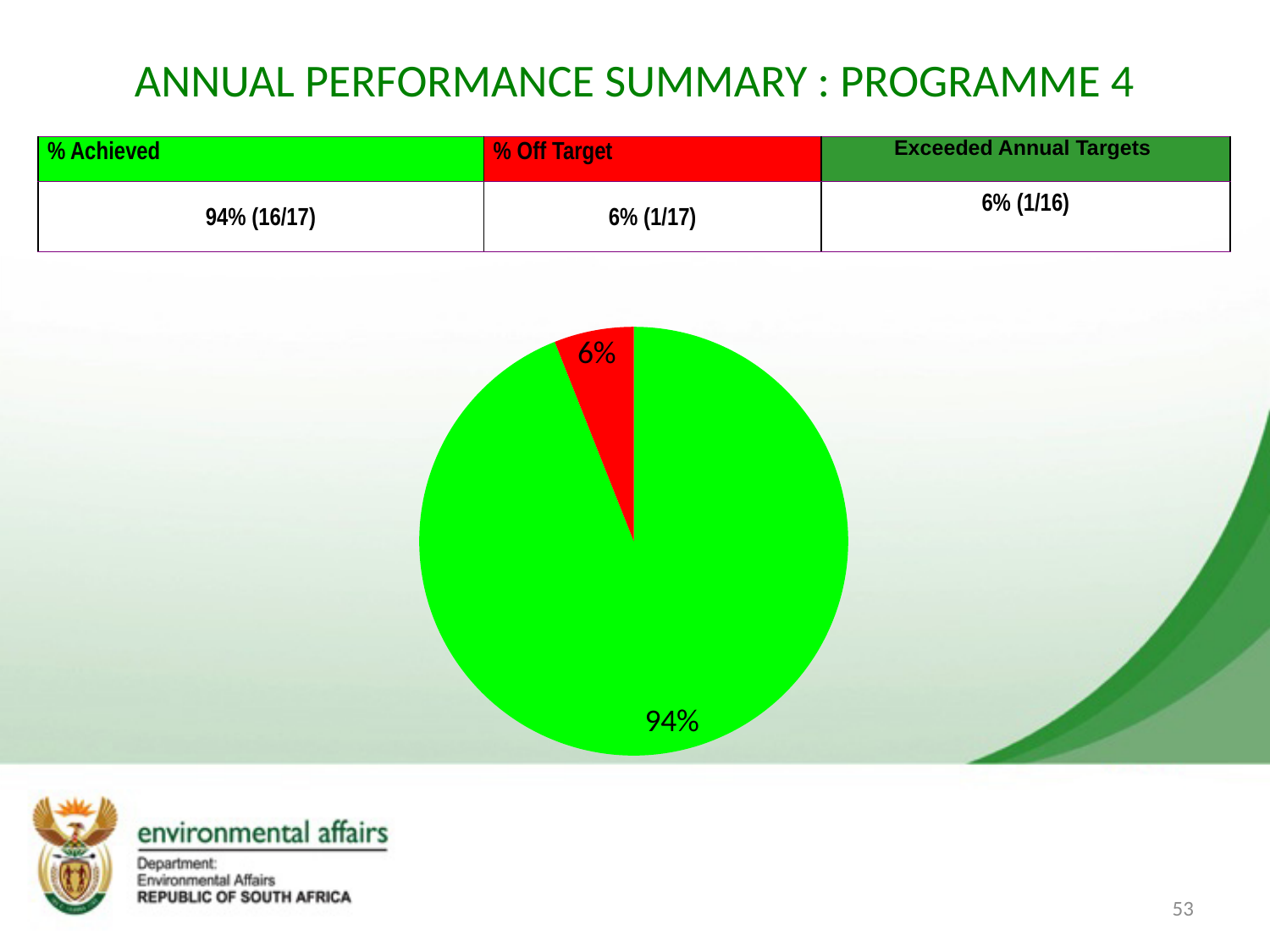
Which slice of the pie chart is the smallest? The red slice (6%) What is the difference in percentage points between the 94% slice and the 6% slice? 88 percentage points What colour is the slice labelled 6%? Red Is the green slice larger or smaller than the red slice? Larger What is the total of the two slices shown in the pie chart? 100% What share of the pie does the green slice represent? 94% How many slices does the pie chart have? 2 Which slice of the pie chart is the largest? The green slice (94%) What kind of chart is shown on the slide? Pie chart What share of the pie does the red slice represent? 6% According to the table above the chart, what does the green colour represent? % Achieved